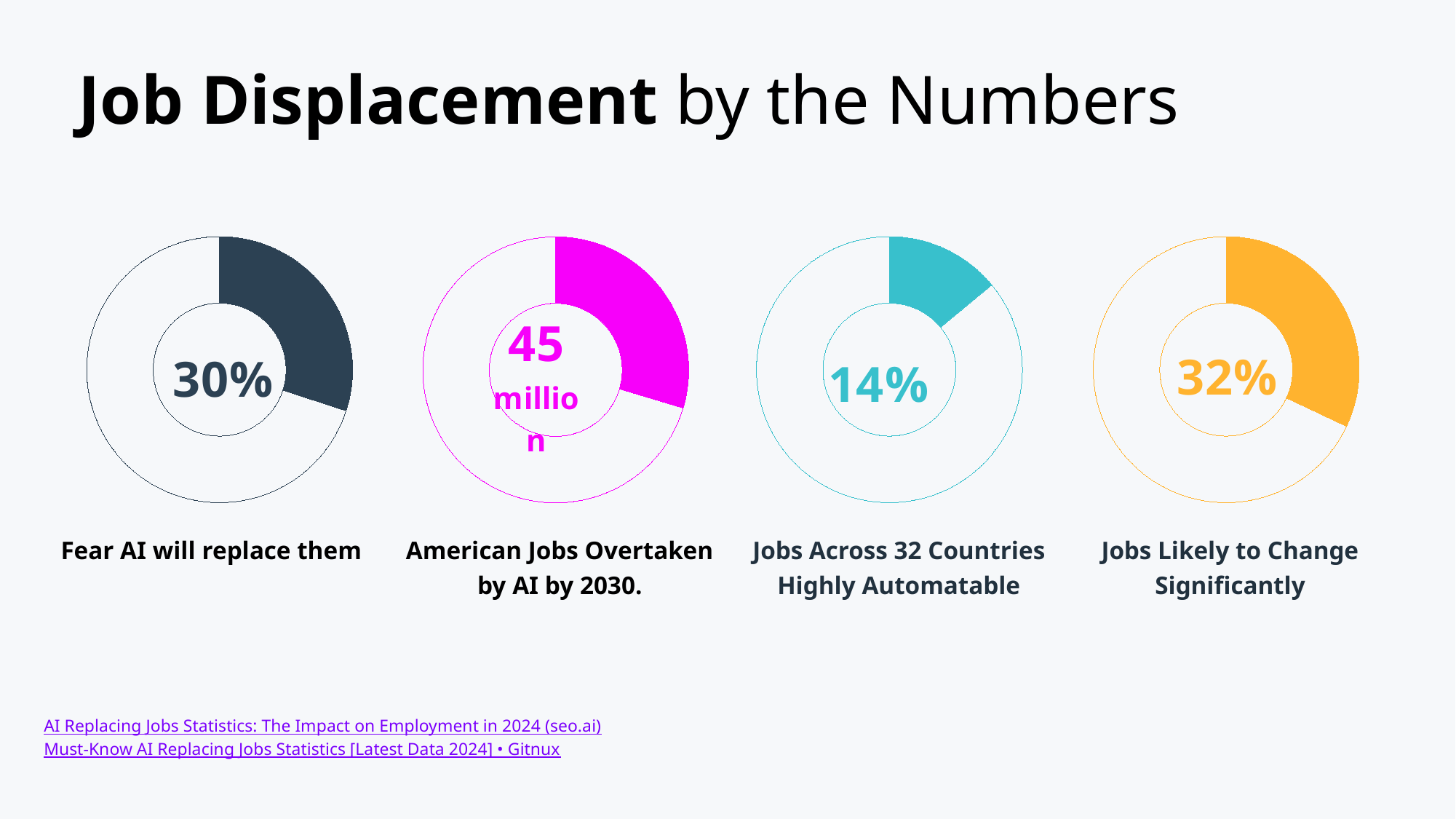
How many donut charts are shown on the slide? 4 Among the three charts showing percentages, which has the highest value? Jobs Likely to Change Significantly (32%) Which is larger: the percentage for "Fear AI will replace them" or for "Jobs Likely to Change Significantly"? Jobs Likely to Change Significantly What value is shown in the donut chart labelled "Jobs Across 32 Countries Highly Automatable"? 14% What colour is the filled segment of the donut chart showing 14%? Teal (cyan) Among the three charts showing percentages, which has the lowest value? Jobs Across 32 Countries Highly Automatable (14%) What is the difference in percentage points between "Jobs Likely to Change Significantly" (32%) and "Fear AI will replace them" (30%)? 2 percentage points What value is shown in the donut chart labelled "American Jobs Overtaken by AI by 2030"? 45 million What is the difference in percentage points between "Jobs Likely to Change Significantly" (32%) and "Jobs Across 32 Countries Highly Automatable" (14%)? 18 percentage points What value is shown in the donut chart labelled "Fear AI will replace them"? 30% What value is shown in the donut chart labelled "Jobs Likely to Change Significantly"? 32% What kind of charts are used on this slide? Donut (pie) charts